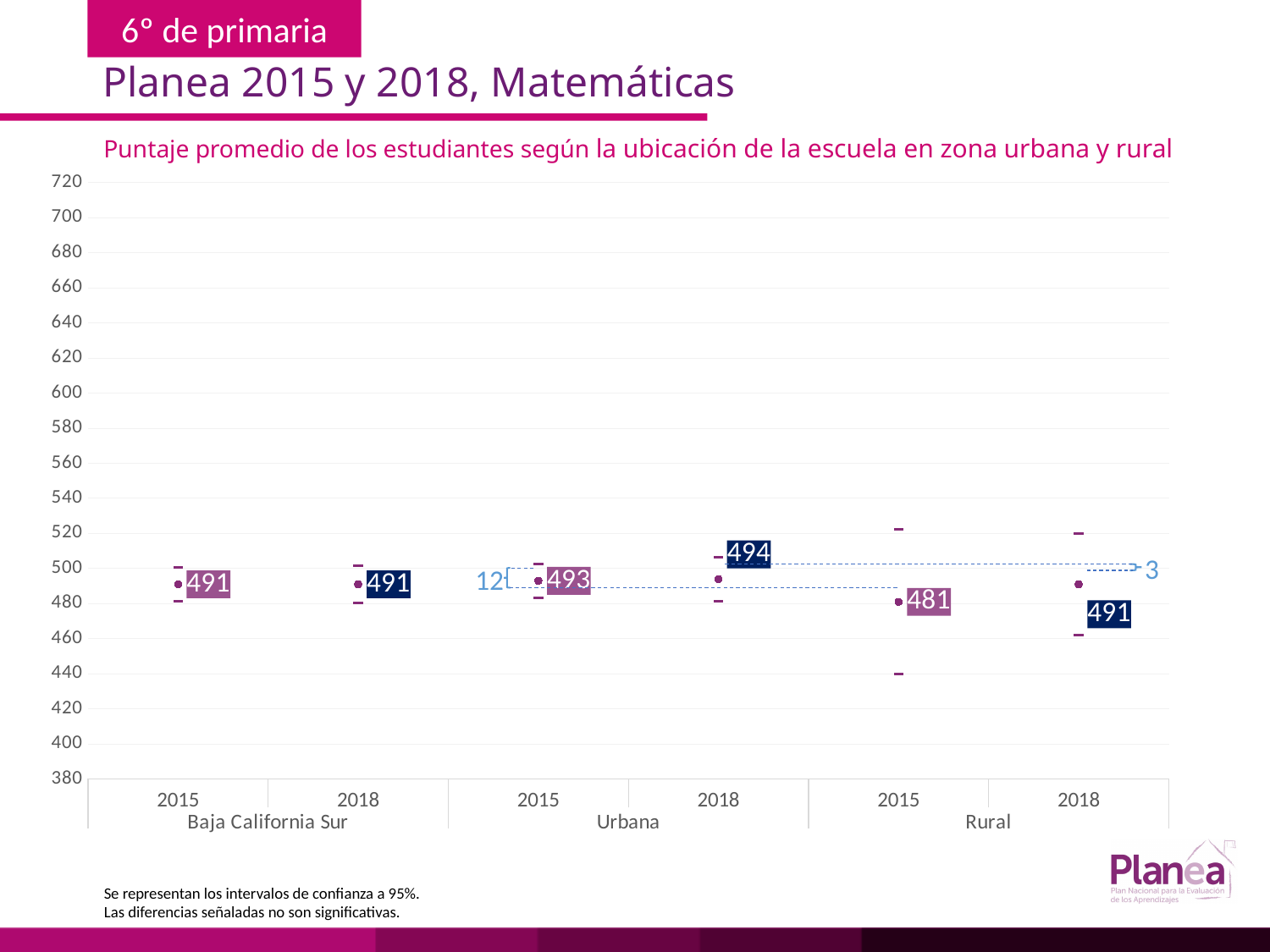
Which group and year has the highest average score? Urbana 2018 Did the Rural average score rise or fall from 2015 to 2018? Rise What is the average score for Urbana schools in 2018? 494 Which group and year has the lowest average score? Rural 2015 What is the difference between the Urbana and Rural average scores in 2015? 12 What is the average score for Baja California Sur in 2015? 491 What is the average score for Rural schools in 2018? 491 What is the title of the chart? Puntaje promedio de los estudiantes según la ubicación de la escuela en zona urbana y rural What is the difference between the Urbana and Rural average scores in 2018? 3 What is the average score for Rural schools in 2015? 481 Which is larger, the Rural score in 2015 or the Rural score in 2018? Rural 2018